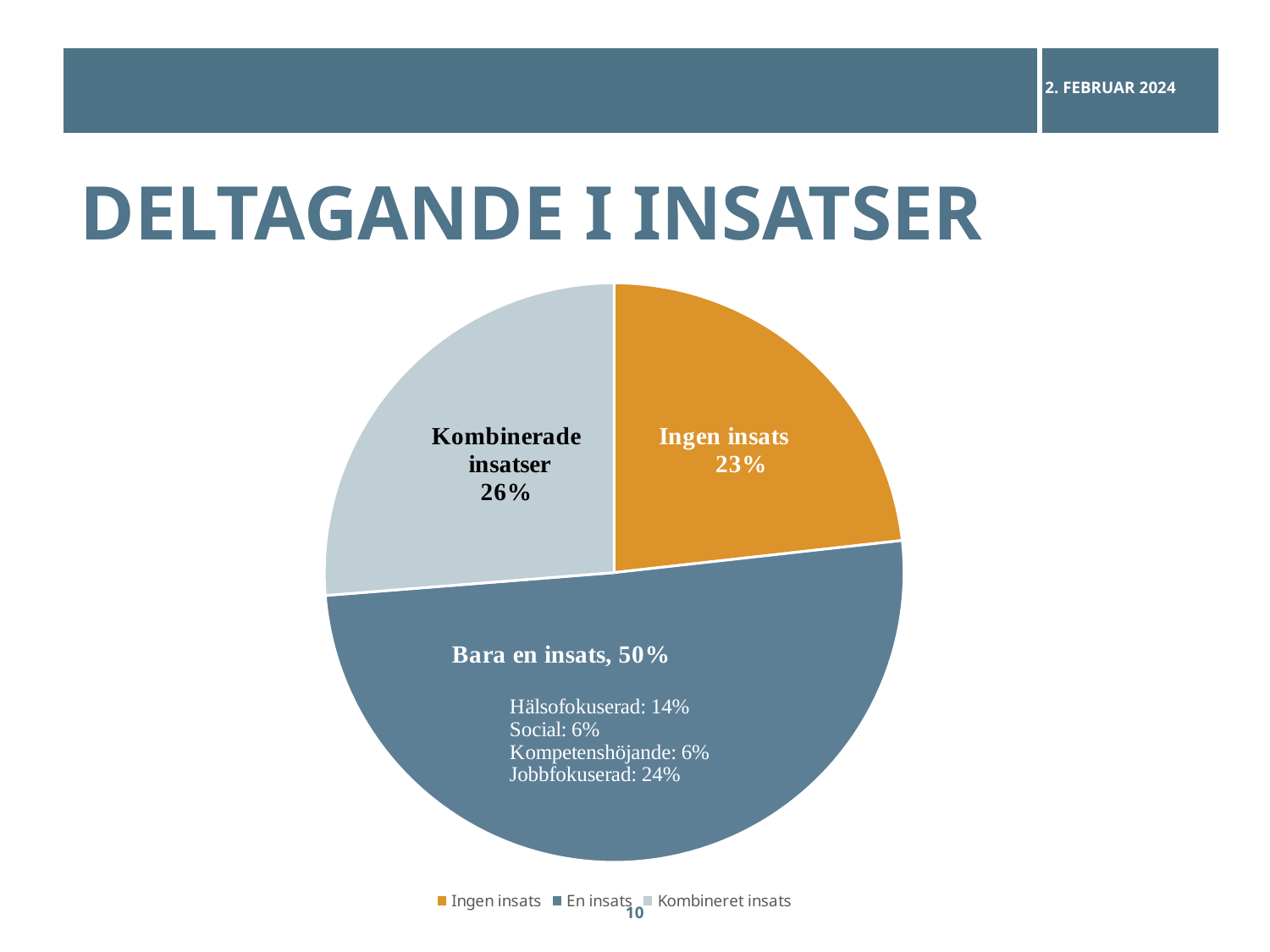
What share of the pie is labelled "Ingen insats"? 23% What kind of chart is shown on the slide? Pie chart How many entries does the legend list? 3 According to the text inside the "Bara en insats" slice, what percentage is "Jobbfokuserad"? 24% What share of the pie is labelled "Bara en insats"? 50% Which is larger, the "Kombinerade insatser" slice or the "Ingen insats" slice? Kombinerade insatser Which slice of the pie is the smallest? Ingen insats What share of the pie is labelled "Kombinerade insatser"? 26% What colour is the "Ingen insats" slice? Orange How many slices does the pie chart have? 3 What is the difference in percentage points between the "Bara en insats" slice and the "Kombinerade insatser" slice? 24 Which slice of the pie is the largest? Bara en insats